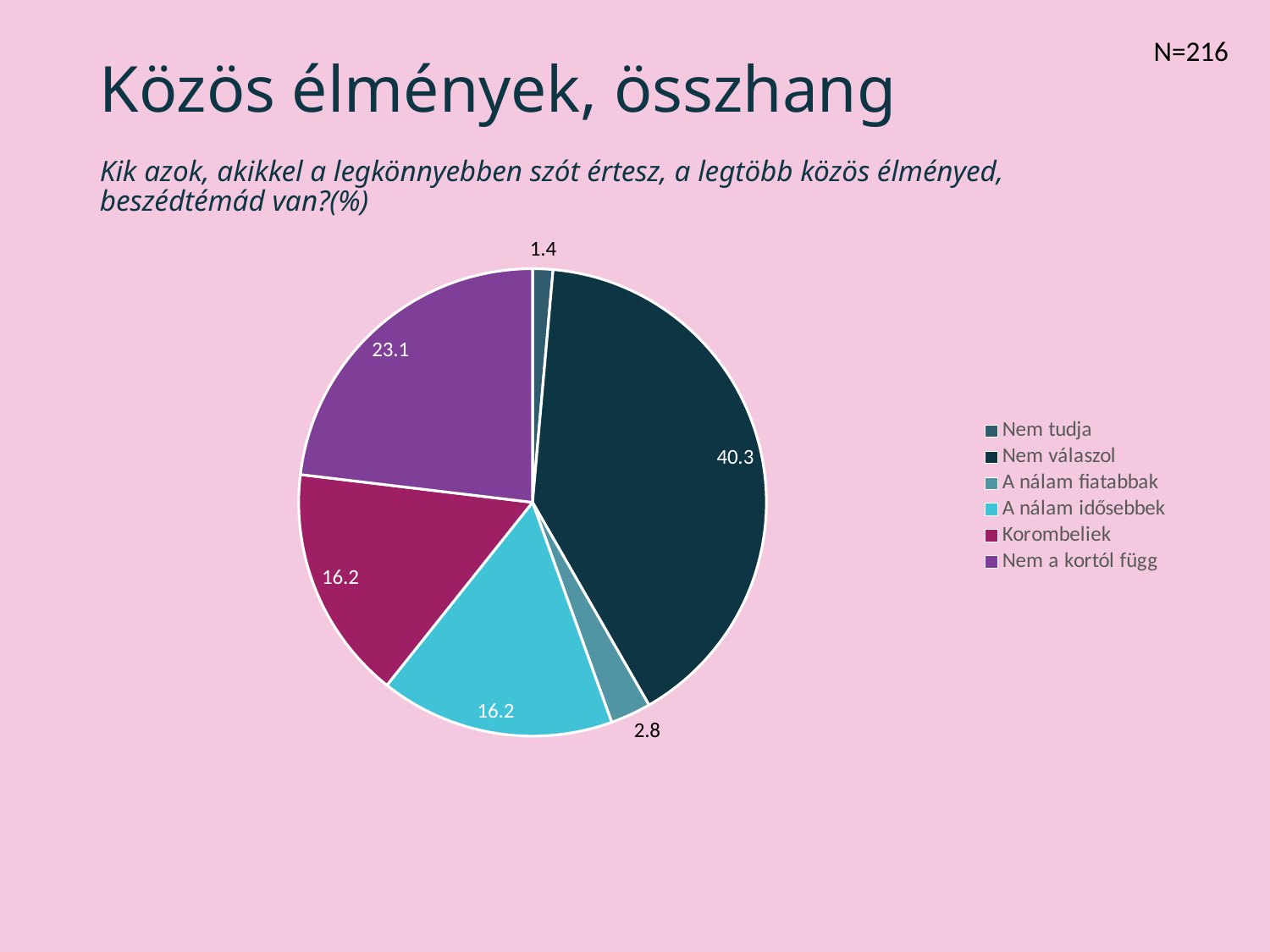
What is the value for "Nem tudja"? 1.4 Which is larger, the value for "A nálam idősebbek" or the value for "A nálam fiatabbak"? A nálam idősebbek How many categories does the legend list? 6 What is the value for "A nálam fiatabbak"? 2.8 Which category has the smallest slice? Nem tudja What is the difference between the values for "Nem válaszol" and "Nem a kortól függ"? 17.2 Which category has the largest slice? Nem válaszol What is the value for "Nem a kortól függ"? 23.1 What kind of chart is shown on the slide? pie chart What is the value for "Nem válaszol"? 40.3 What is the value for "Korombeliek"? 16.2 What sample size (N) is shown on the slide? N=216